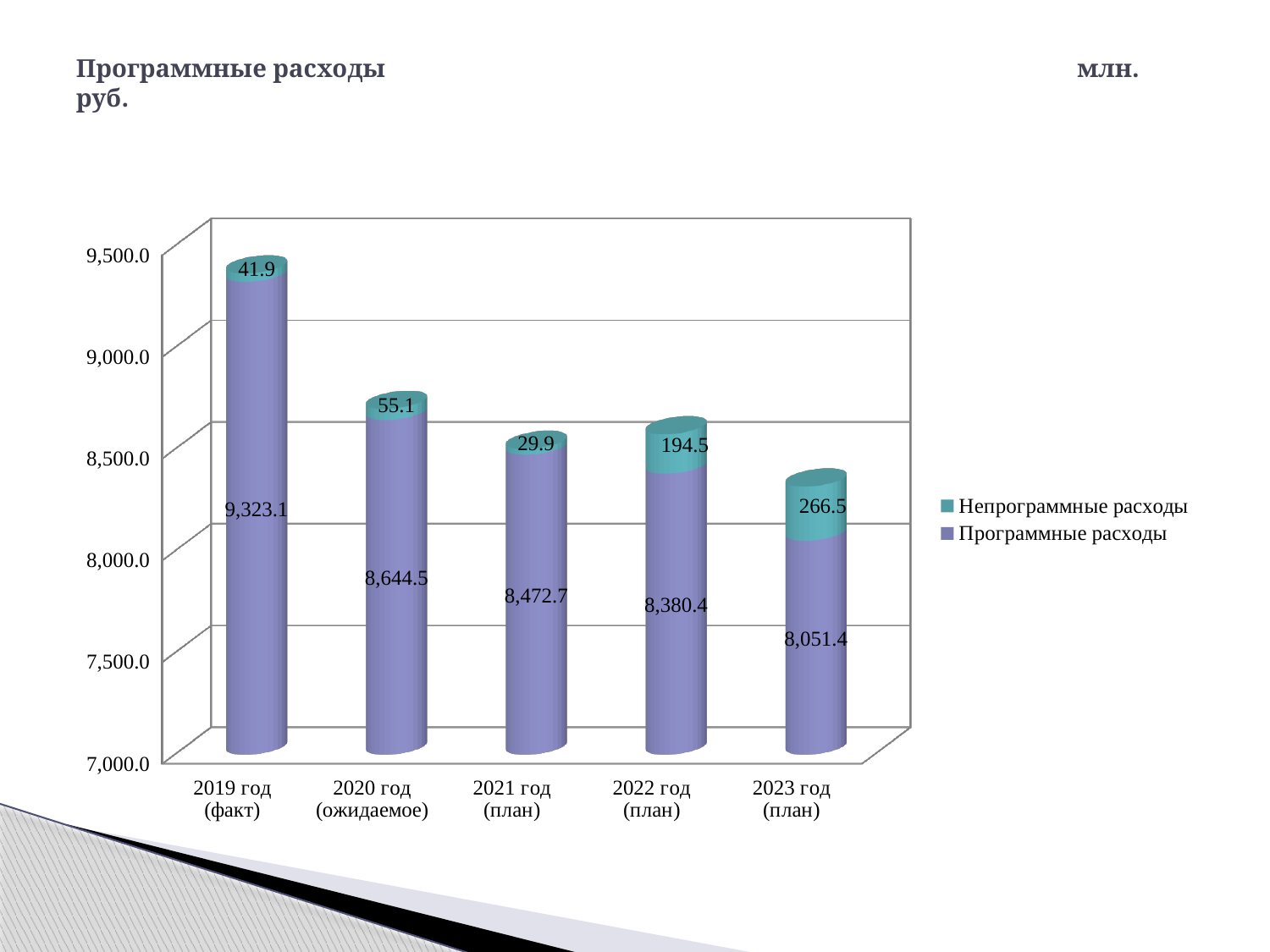
How many series does the legend list? 2 Which is larger: Непрограммные расходы in 2022 год (план) or in 2023 год (план)? 2023 год (план) How many years (categories) are shown on the x axis? 5 What is the difference between Программные расходы in 2019 год (факт) and 2020 год (ожидаемое)? 678.6 What is the total of the stacked bar for 2023 год (план)? 8,317.9 What is the value of Программные расходы for 2019 год (факт)? 9,323.1 What kind of chart is shown on the slide? Stacked bar chart Do the values of Программные расходы rise or fall from 2019 to 2023? Fall What is the value of Программные расходы for 2021 год (план)? 8,472.7 What is the value of Непрограммные расходы for 2023 год (план)? 266.5 Which year has the highest value of Программные расходы? 2019 год (факт) Which year has the lowest value of Непрограммные расходы? 2021 год (план)